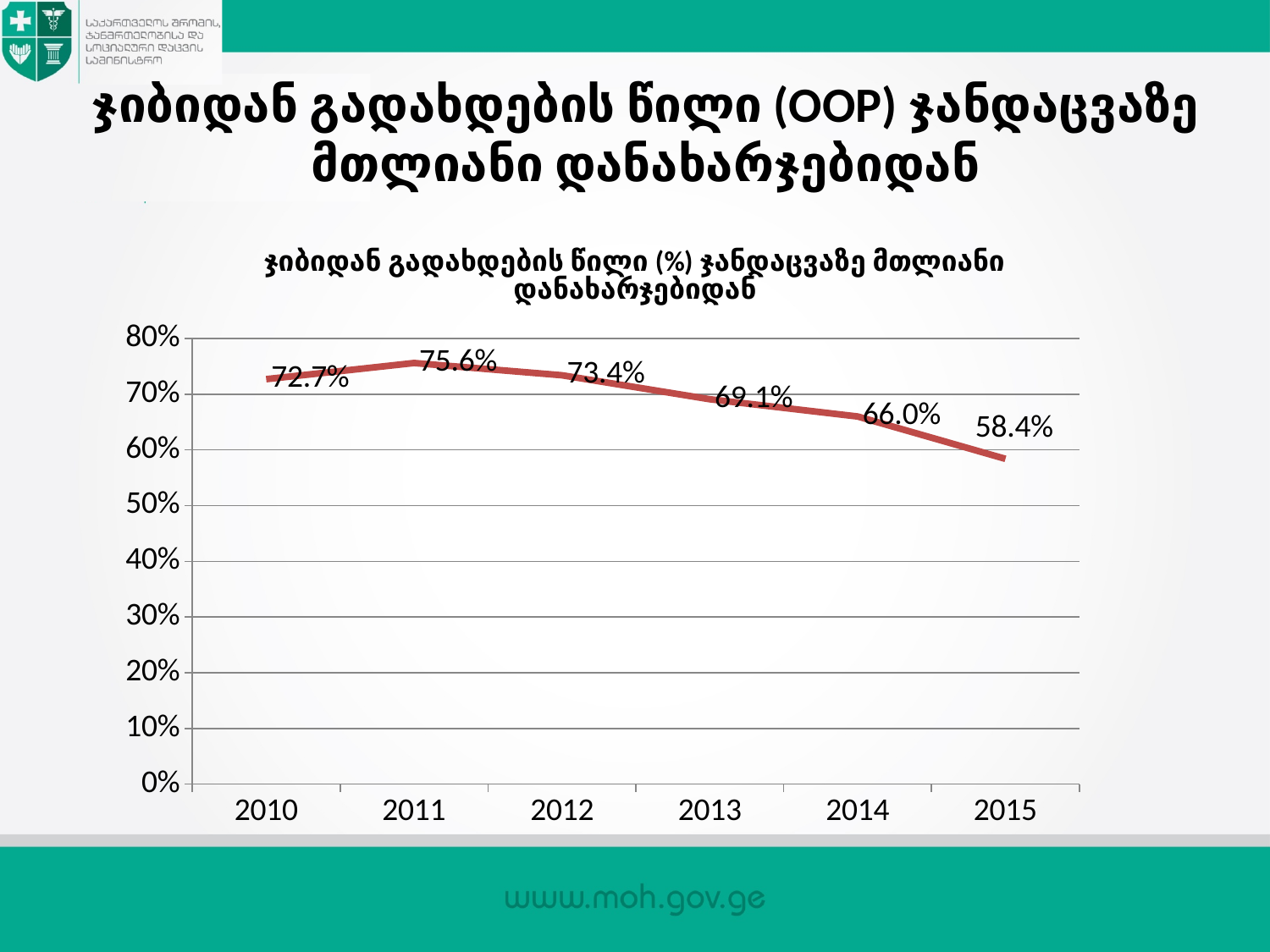
How many years are plotted on the chart? 6 Is the value for 2015 greater or less than 60%? less What is the value for 2015? 58.4% What is the value for 2013? 69.1% What colour is the line on the chart? red Which year has the lowest value? 2015 What kind of chart is shown? line chart Which is larger, the value for 2012 or the value for 2014? 2012 What is the value for 2010? 72.7% Do the values rise or fall from 2011 to 2015? fall Which year has the highest value? 2011 What is the difference between the values for 2011 and 2015? 17.2%